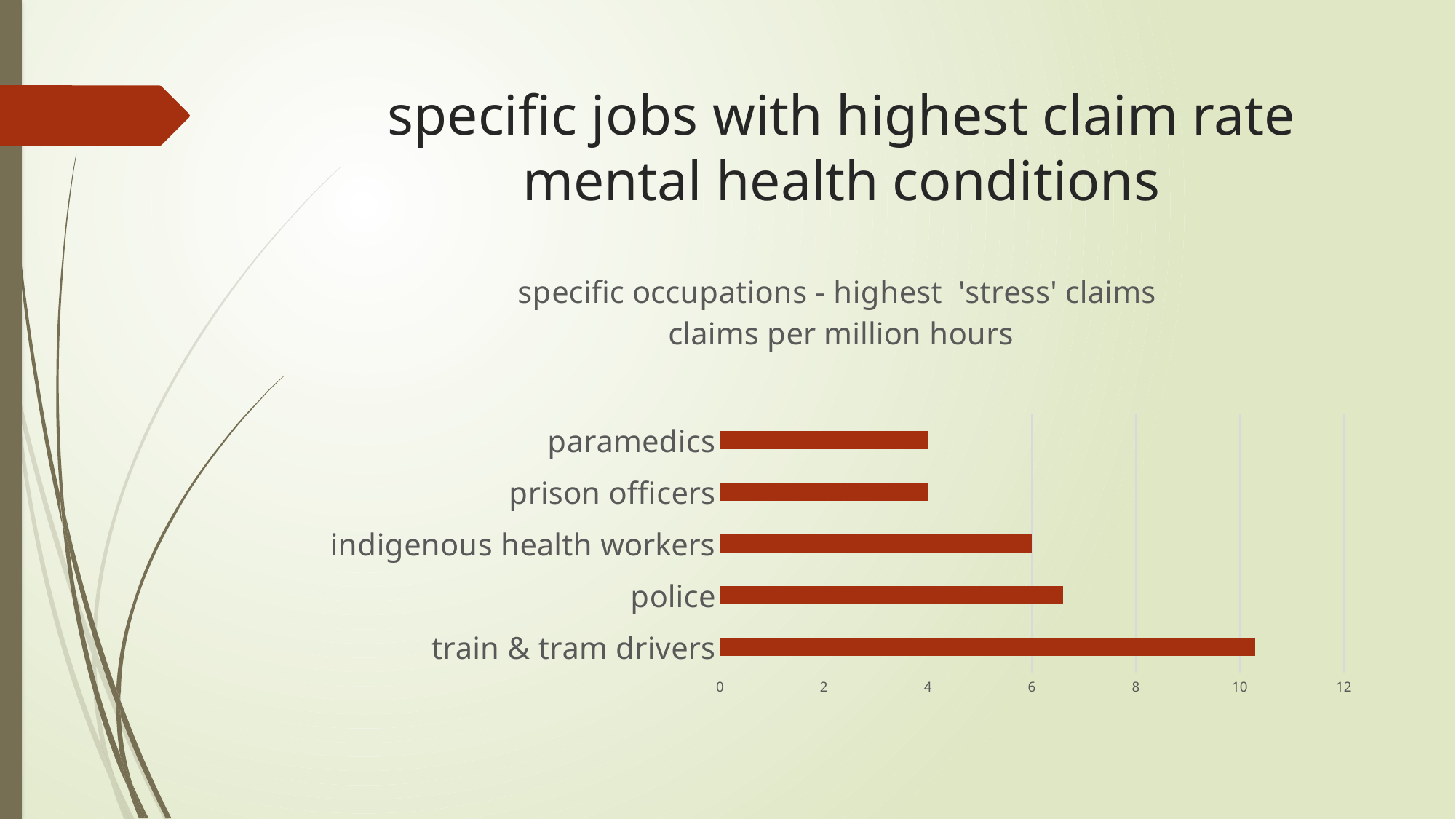
Which has the larger value, police or indigenous health workers? police Which occupation has the highest claims per million hours? train & tram drivers How many occupations are plotted in the chart? 5 Is the value for police greater or less than 8? less What kind of chart is shown on the slide? bar chart What is the value for indigenous health workers? 6 What unit does the chart subtitle say the values are measured in? claims per million hours Is the value for train & tram drivers greater or less than 12? less Is the value for train & tram drivers greater or less than 10? greater Which has the larger value, train & tram drivers or police? train & tram drivers What is the value for paramedics? 4